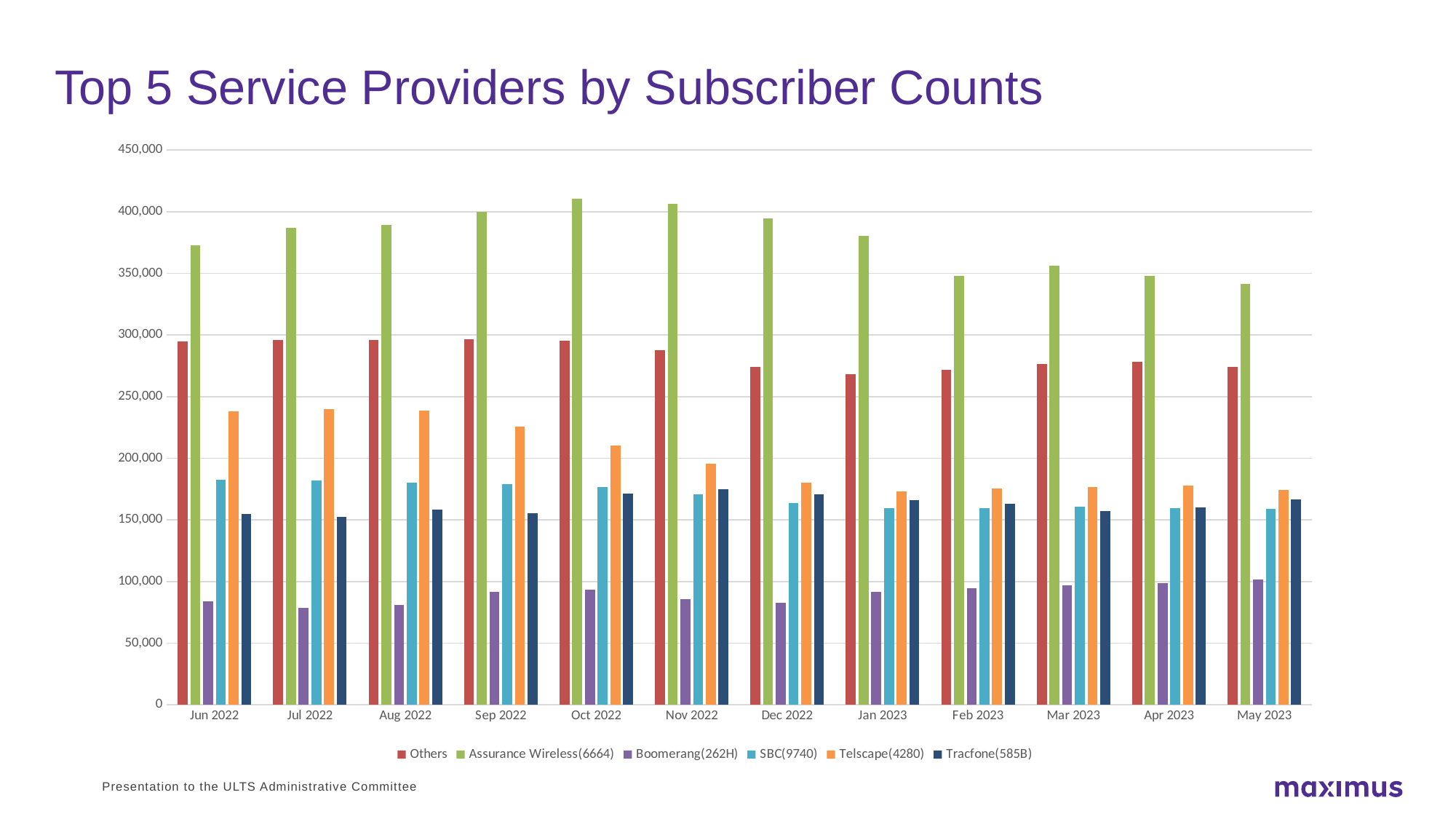
Is the value for Telscape(4280) in May 2023 greater or less than 200,000? less What kind of chart is shown on the slide? Bar chart How many months are shown along the x axis of the chart? 12 In Jun 2022, which is larger: the value for Telscape(4280) or the value for SBC(9740)? Telscape(4280) Is the value for Boomerang(262H) in Jul 2022 greater or less than 100,000? less Which service provider has the highest subscriber count in every month shown? Assurance Wireless(6664) Does the value for Telscape(4280) rise or fall from Jun 2022 to May 2023? fall How many series does the chart's legend list? 6 Which service provider has the lowest subscriber count in every month shown? Boomerang(262H) What is the title of the chart? Top 5 Service Providers by Subscriber Counts Is the value for Telscape(4280) in Jun 2022 greater or less than 200,000? greater